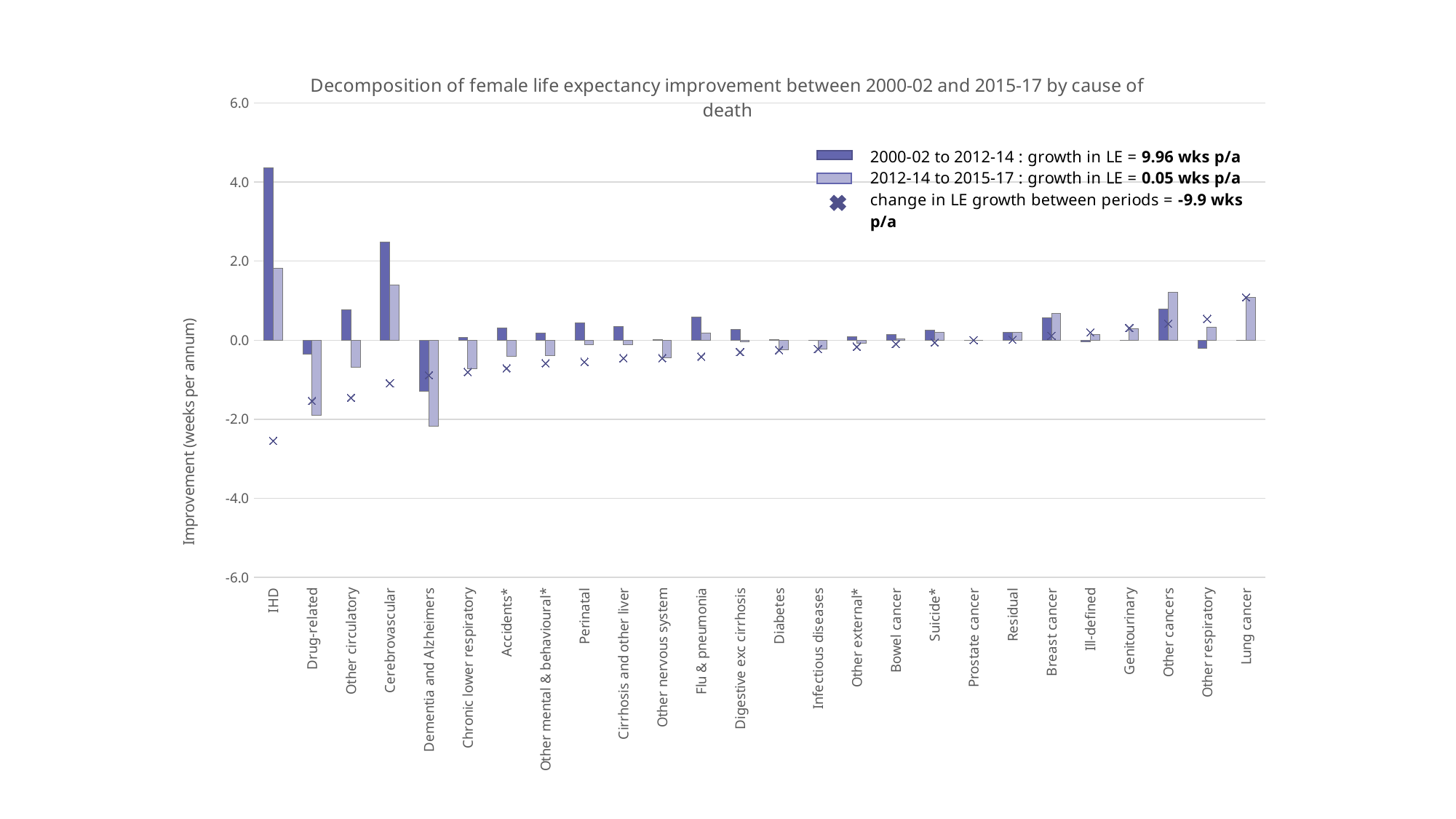
How many entries does the legend list? 3 For the 2012-14 to 2015-17 series, which is larger: Drug-related or Other circulatory? Other circulatory What kind of chart is shown on the slide? bar chart Is the 2012-14 to 2015-17 value for Drug-related greater or less than -1.0? less For the 2000-02 to 2012-14 series, which is larger: IHD or Cerebrovascular? IHD Is the 2000-02 to 2012-14 value for IHD greater or less than 4.0? greater According to the legend, what was the growth in LE for the 2000-02 to 2012-14 period? 9.96 wks p/a Which cause of death has the lowest value for the 2012-14 to 2015-17 series? Dementia and Alzheimers How many causes of death are listed along the x axis? 26 Which cause of death has the lowest value for the 2000-02 to 2012-14 series? Dementia and Alzheimers Which cause of death has the lowest 'change in LE growth between periods' marker? IHD Which cause of death has the highest value for the 2000-02 to 2012-14 series? IHD